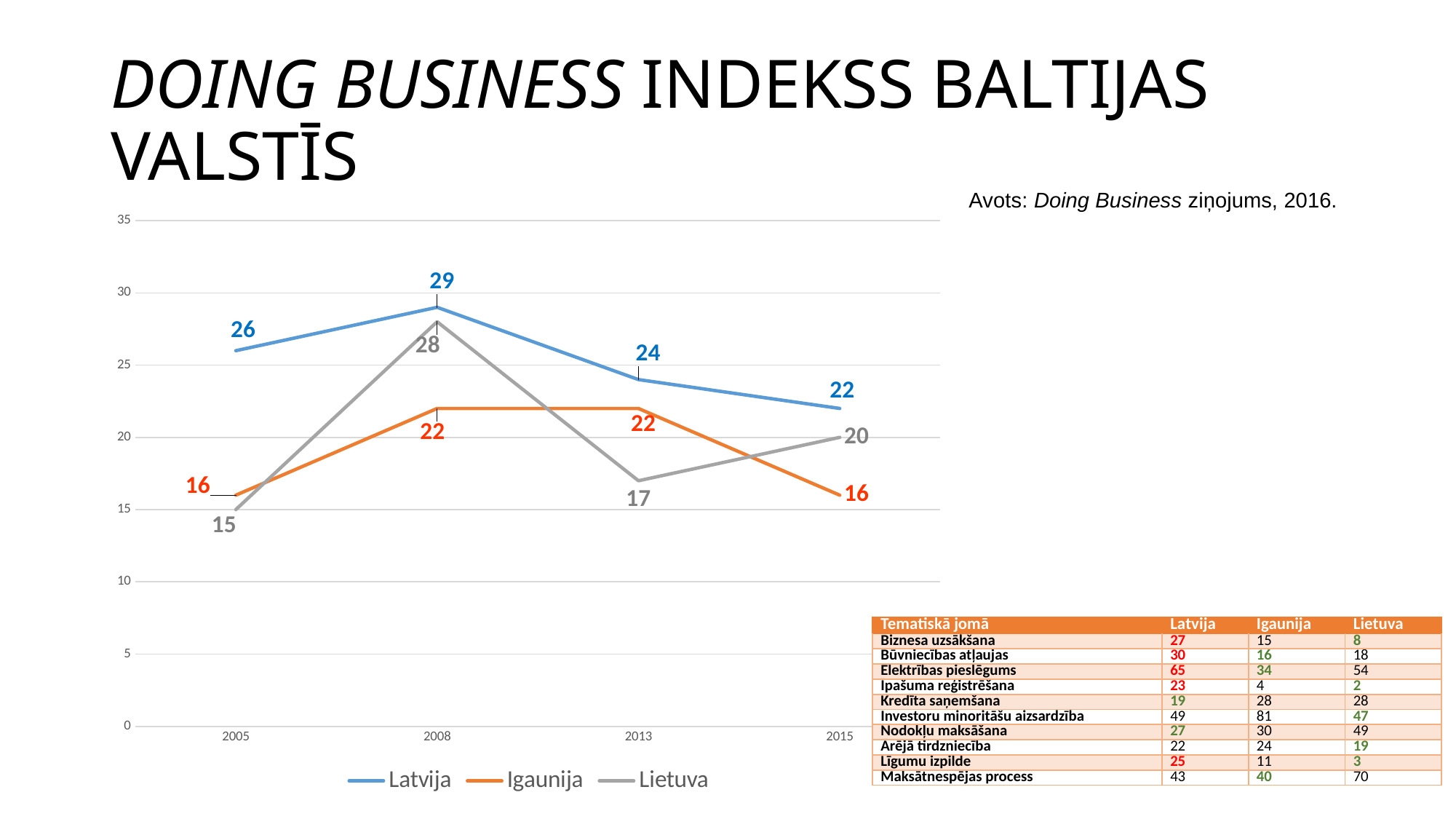
In which year does Latvija reach its highest value? 2008 What type of chart is shown on the slide? line chart Which colour is used for the Igaunija line? orange How many series does the chart legend list? 3 What is the value for Igaunija in 2015? 16 How many years are plotted on the x axis? 4 What is the difference between the Latvija and Igaunija values in 2013? 2 What is the value for Lietuva in 2005? 15 Does the Latvija line rise or fall from 2008 to 2015? fall Which series has the higher value in 2015, Igaunija or Lietuva? Lietuva What is the value for Latvija in 2008? 29 In which year does Lietuva have its lowest value? 2005